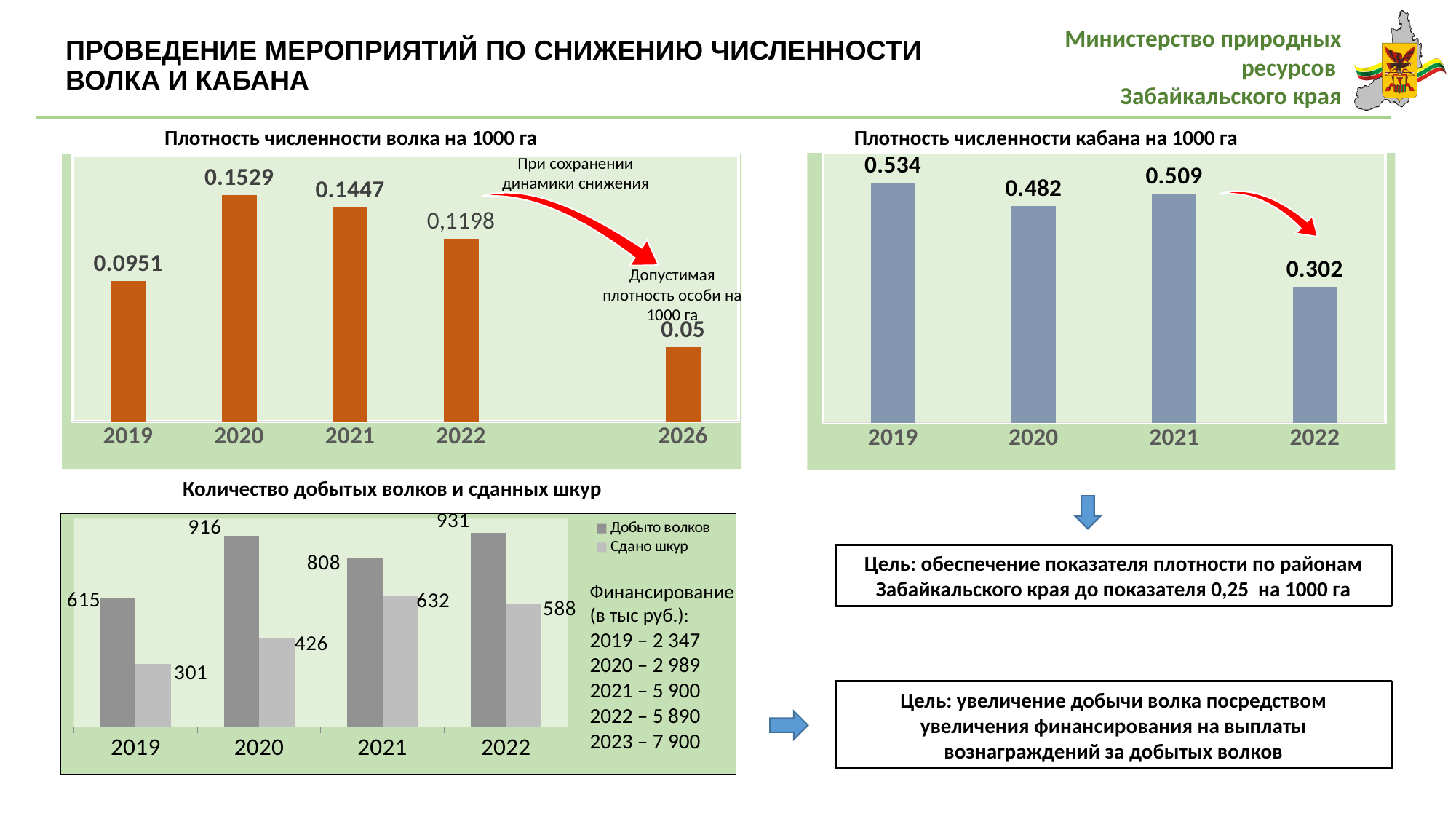
In the chart 'Плотность численности кабана на 1000 га', what is the value for 2021? 0.509 In the chart 'Плотность численности волка на 1000 га', how many years are shown on the x axis? 5 In the chart 'Плотность численности волка на 1000 га', what is the value shown for 2026? 0.05 In the chart 'Плотность численности волка на 1000 га', what is the value for 2020? 0.1529 In the chart 'Плотность численности волка на 1000 га', which year has the highest value? 2020 In the chart 'Плотность численности кабана на 1000 га', which year has the lowest value? 2022 In the chart 'Количество добытых волков и сданных шкур', what is the value of 'Сдано шкур' for 2021? 632 In the chart 'Количество добытых волков и сданных шкур', how many series does the legend list? 2 In the chart 'Количество добытых волков и сданных шкур', what is the difference between 'Добыто волков' and 'Сдано шкур' in 2019? 314 In the chart 'Плотность численности кабана на 1000 га', which is larger, the value for 2019 or 2020? 2019 What type of chart is 'Количество добытых волков и сданных шкур'? Bar chart In the chart 'Плотность численности кабана на 1000 га', what is the difference between the 2019 and 2022 values? 0.232